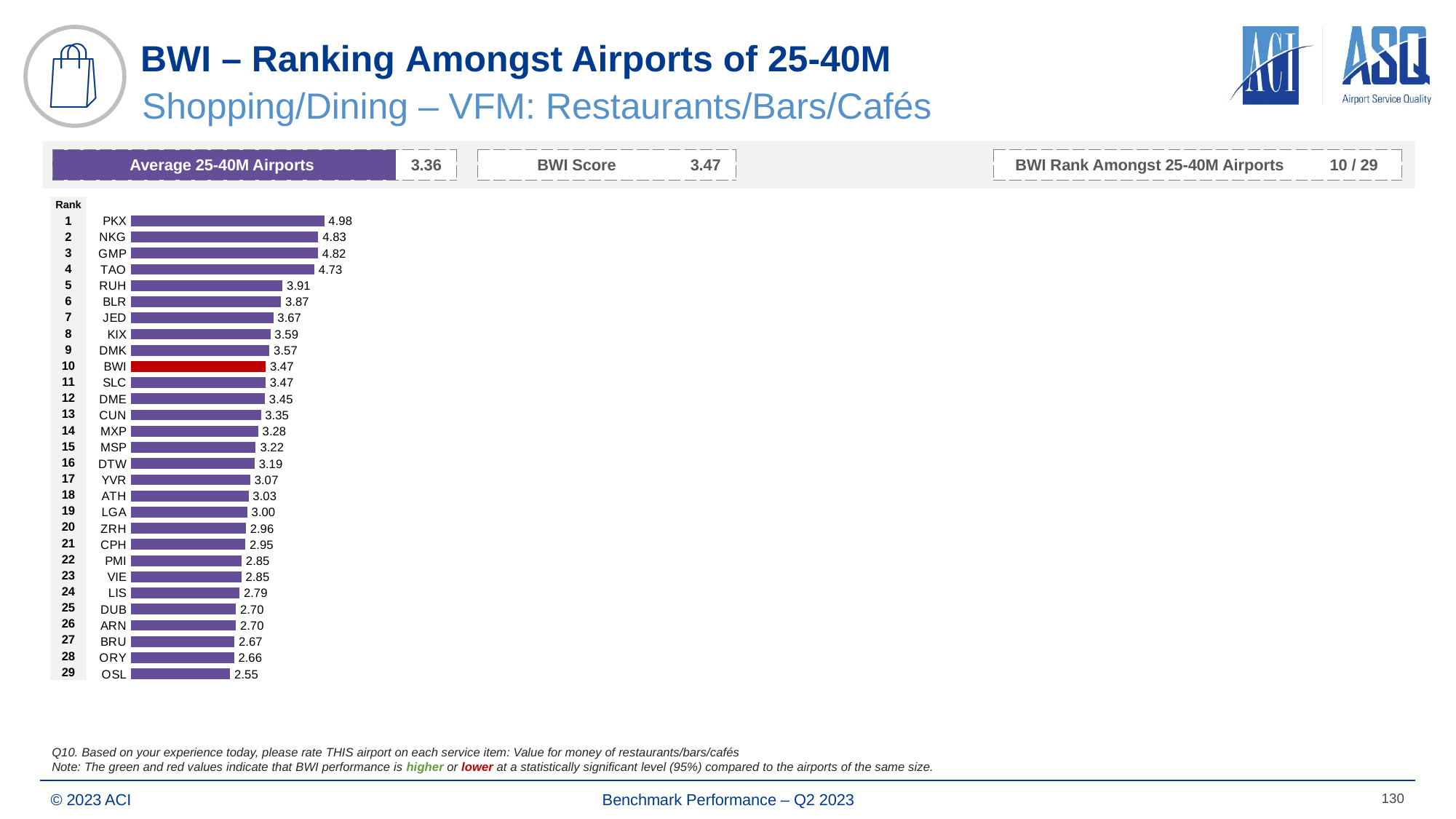
How many airports are ranked in the chart? 29 Which bar is coloured red in the chart? BWI Which airport has the highest value? PKX Which airport has the lowest value? OSL Do the values rise or fall going down the ranked list from rank 1 to rank 29? fall What is the value for PKX? 4.98 What is the difference between the values for PKX and OSL? 2.43 What kind of chart is shown on the slide? bar chart What is the value for OSL? 2.55 What is the value for BWI? 3.47 Which is larger, the value for RUH or the value for JED? RUH What is the difference between the values for BWI and DTW? 0.28